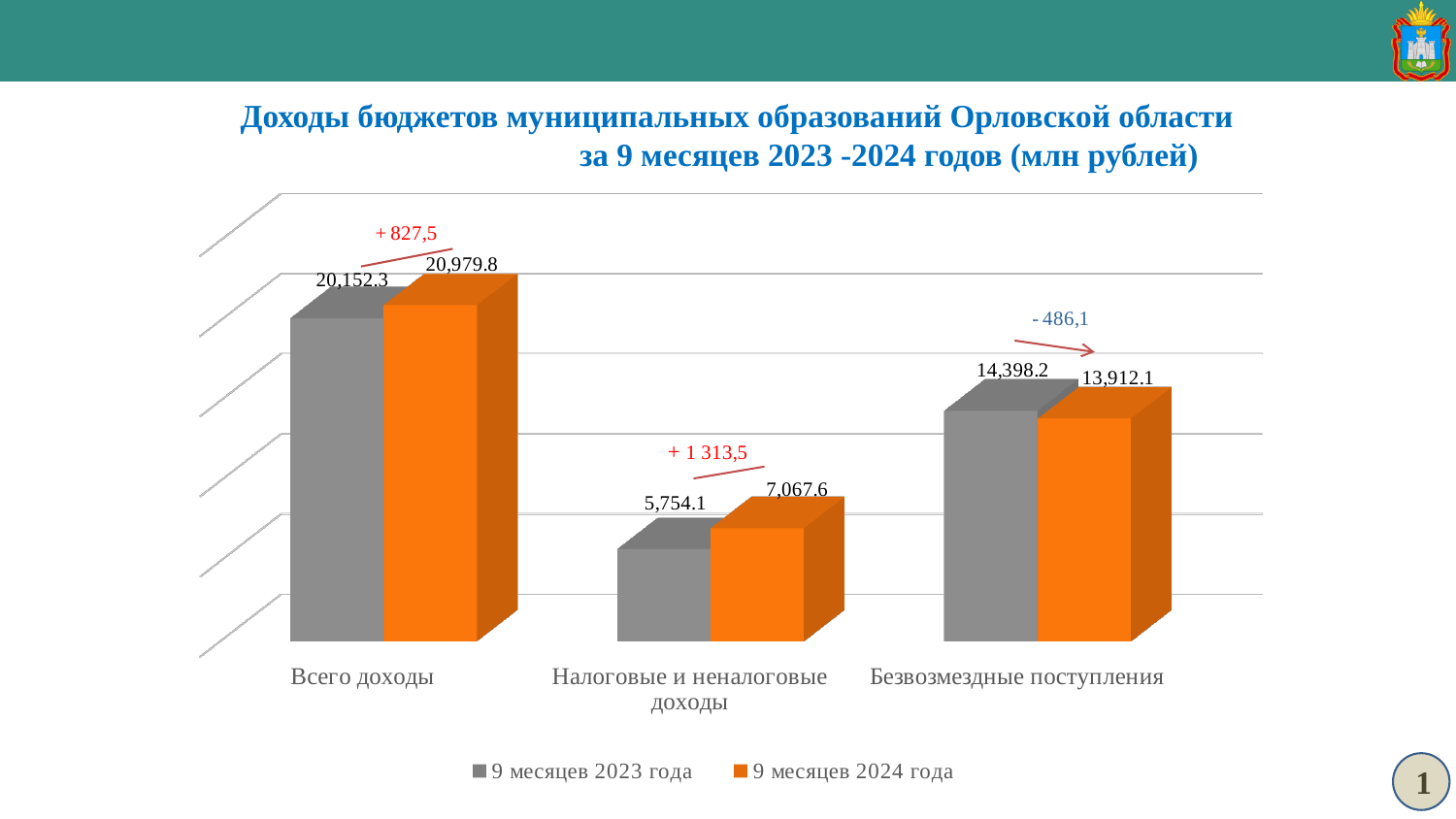
What is the value for «Налоговые и неналоговые доходы» in the «9 месяцев 2024 года» series? 7,067.6 What is the value for «Безвозмездные поступления» in the «9 месяцев 2024 года» series? 13,912.1 What is the value for «Всего доходы» in the «9 месяцев 2024 года» series? 20,979.8 What is the value for «Налоговые и неналоговые доходы» in the «9 месяцев 2023 года» series? 5,754.1 How many categories are shown on the x axis? 3 What kind of chart is shown on the slide? Bar chart What is the value for «Всего доходы» in the «9 месяцев 2023 года» series? 20,152.3 What is the difference between the 2024 and 2023 values for «Налоговые и неналоговые доходы»? 1,313.5 Which is larger for «Безвозмездные поступления»: the 2023 value or the 2024 value? 9 месяцев 2023 года Which category has the lowest value in the «9 месяцев 2023 года» series? Налоговые и неналоговые доходы Which category has the highest value in the «9 месяцев 2024 года» series? Всего доходы How many series does the legend list? 2